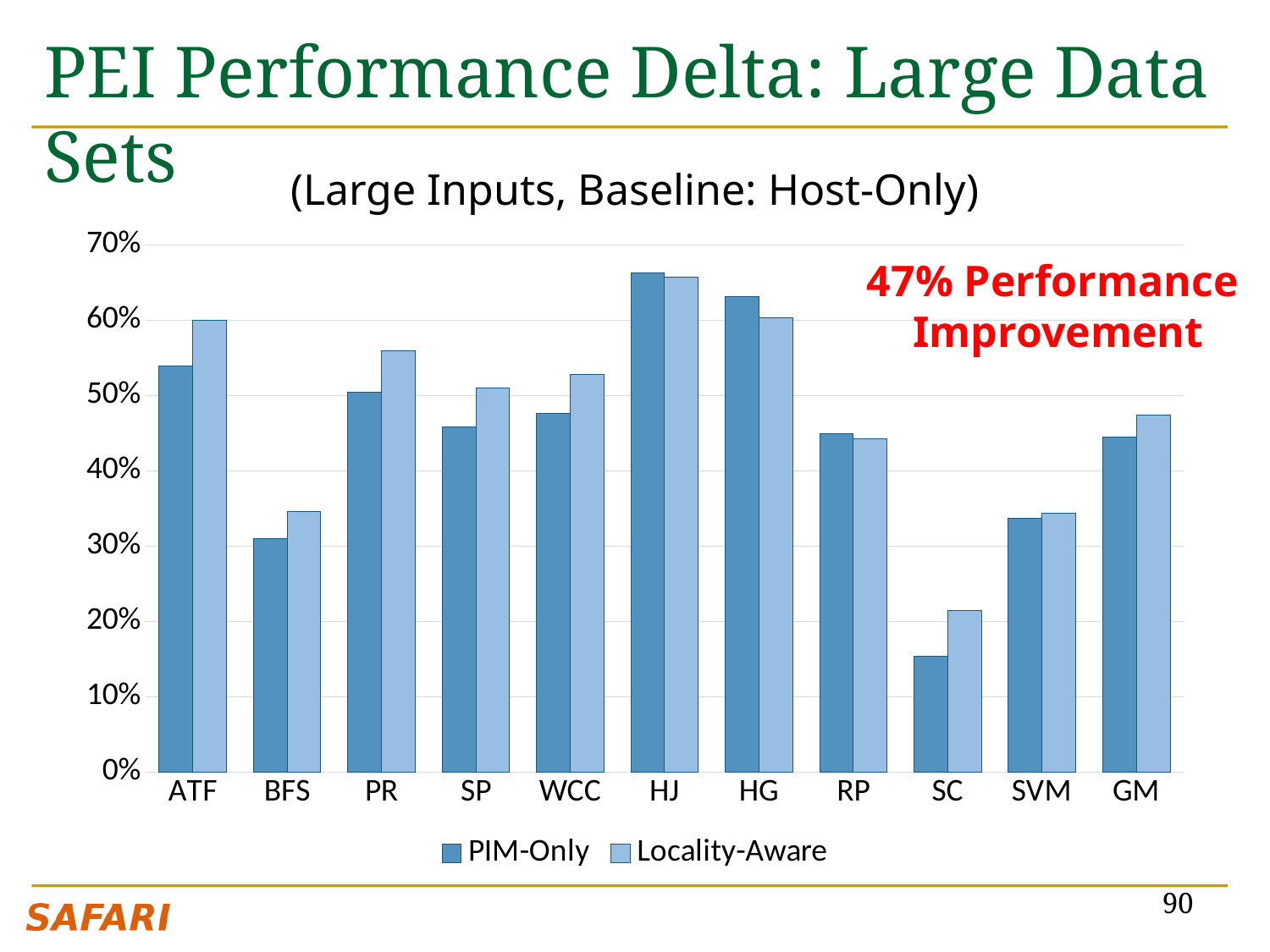
Is the PIM-Only value for SC greater or less than 20%? less Is the PIM-Only value for HJ greater or less than 60%? greater For HG, which series has the larger value, PIM-Only or Locality-Aware? PIM-Only What are the two series named in the legend? PIM-Only and Locality-Aware Which category has the lowest Locality-Aware value? SC Is the Locality-Aware value for PR greater or less than 50%? greater How many categories are shown on the x axis? 11 How many series does the legend list? 2 Which category has the highest PIM-Only value? HJ Which category has the lowest PIM-Only value? SC For ATF, which series has the larger value, PIM-Only or Locality-Aware? Locality-Aware What kind of chart is shown on the slide? bar chart